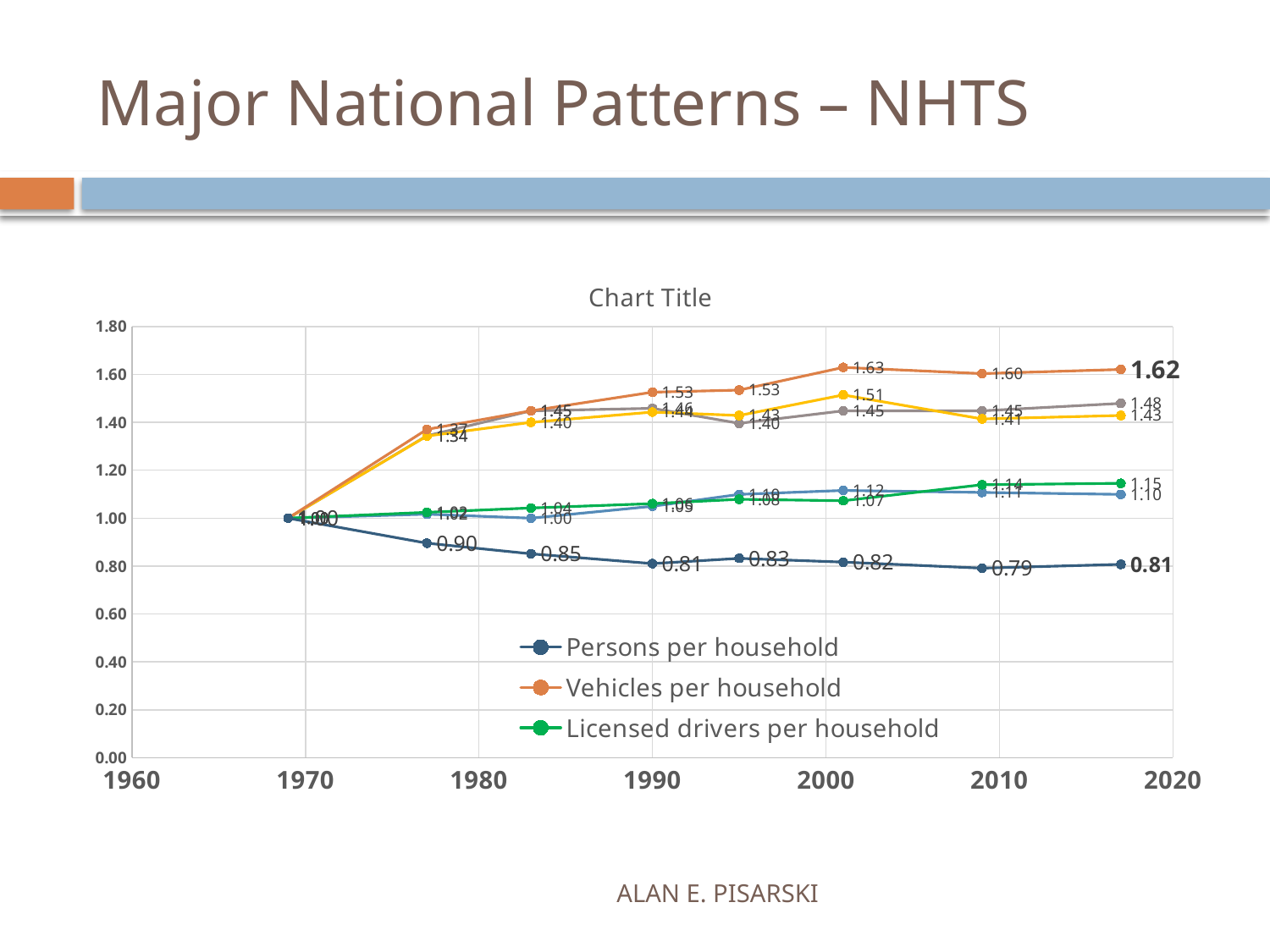
What is the lowest value reached by the Persons per household series? 0.79 What is the final (rightmost) value of the Vehicles per household series? 1.62 How many data points are plotted for the Persons per household series? 8 What title is displayed above the chart? Chart Title How many series does the chart legend list? 3 What is the final (rightmost) value of the Persons per household series? 0.81 What is the highest value reached by the Vehicles per household series? 1.63 What kind of chart is shown on the slide? line chart At the rightmost data point, which is larger: Vehicles per household or Persons per household? Vehicles per household Does the Persons per household series generally rise or fall from 1970 to 2020? fall Does the Vehicles per household series generally rise or fall from 1970 to 2020? rise At the rightmost data point, what is the difference between Vehicles per household (1.62) and Persons per household (0.81)? 0.81